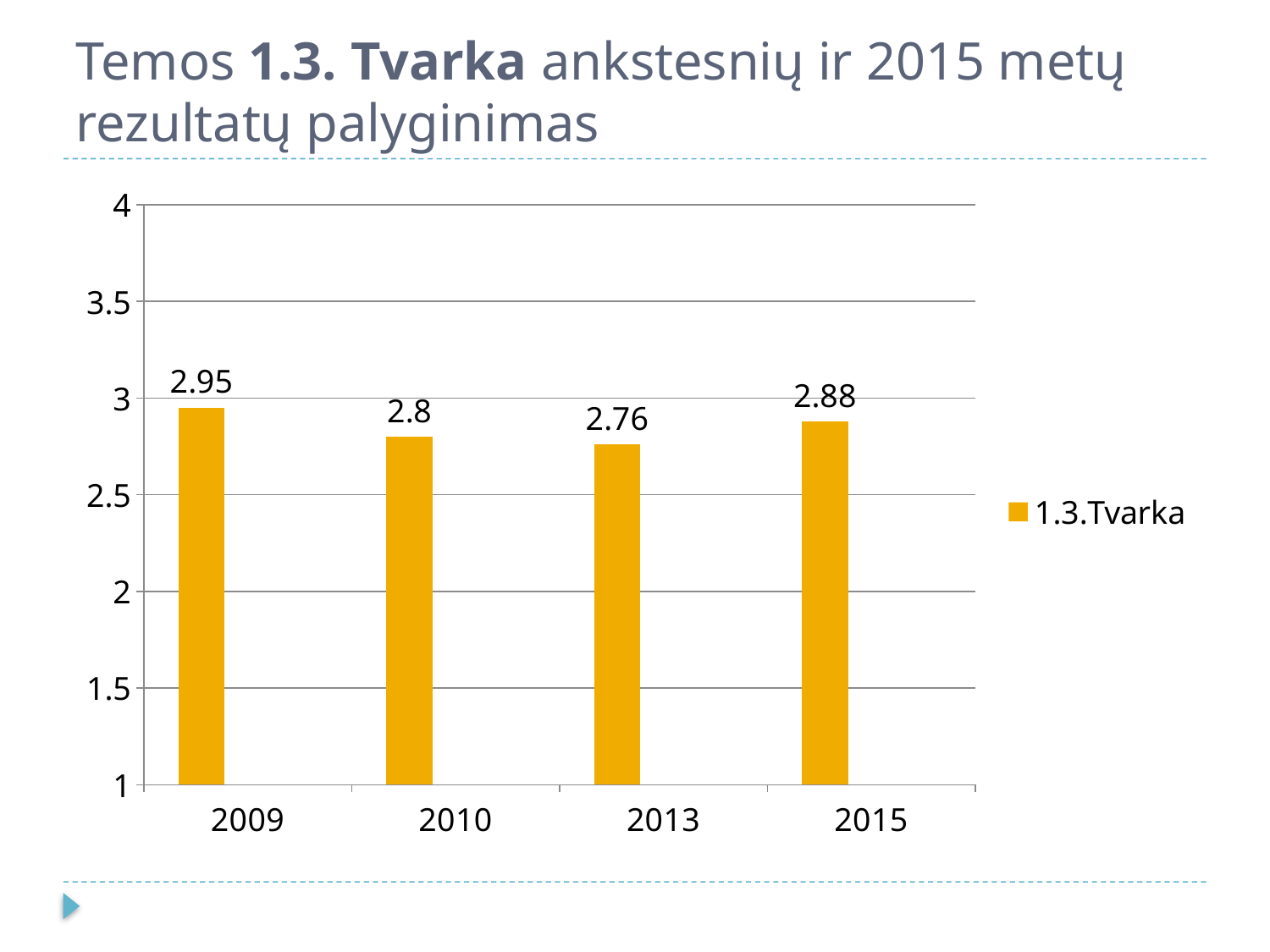
What is the difference between the values for 2015 and 2010? 0.08 What series name does the legend show? 1.3.Tvarka Which year has the lowest value? 2013 Which is larger, the value for 2010 or the value for 2015? 2015 Is the value for 2009 greater or less than 3? less What is the difference between the values for 2009 and 2013? 0.19 What is the value for 2009? 2.95 How many years are shown on the x axis? 4 What kind of chart is shown on the slide? bar chart What is the value for 2013? 2.76 Which year has the highest value? 2009 What is the value for 2015? 2.88